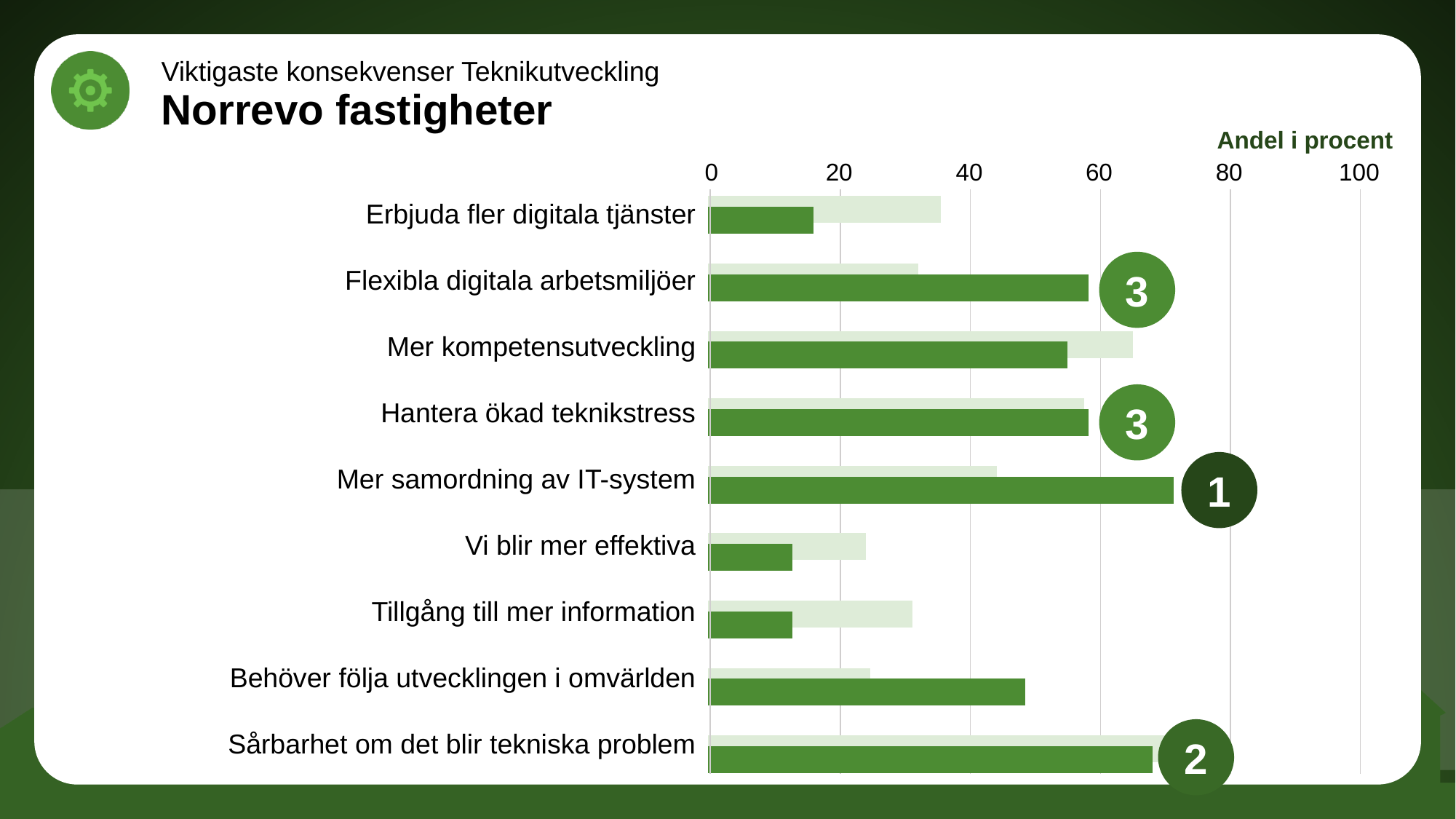
Which category has the longest dark green bar? Mer samordning av IT-system Is the dark green bar for Vi blir mer effektiva greater or less than 20? less What kind of chart is shown on the slide? bar chart What number is shown in the dark circle next to the bar for Mer samordning av IT-system? 1 Is the dark green bar for Erbjuda fler digitala tjänster greater or less than 20? less Is the dark green bar for Behöver följa utvecklingen i omvärlden greater or less than 40? greater Which has the longer light green bar: Erbjuda fler digitala tjänster or Behöver följa utvecklingen i omvärlden? Erbjuda fler digitala tjänster Which has the longer dark green bar: Flexibla digitala arbetsmiljöer or Vi blir mer effektiva? Flexibla digitala arbetsmiljöer What is the label shown above the horizontal axis of the chart? Andel i procent How many categories are listed on the vertical axis of the chart? 9